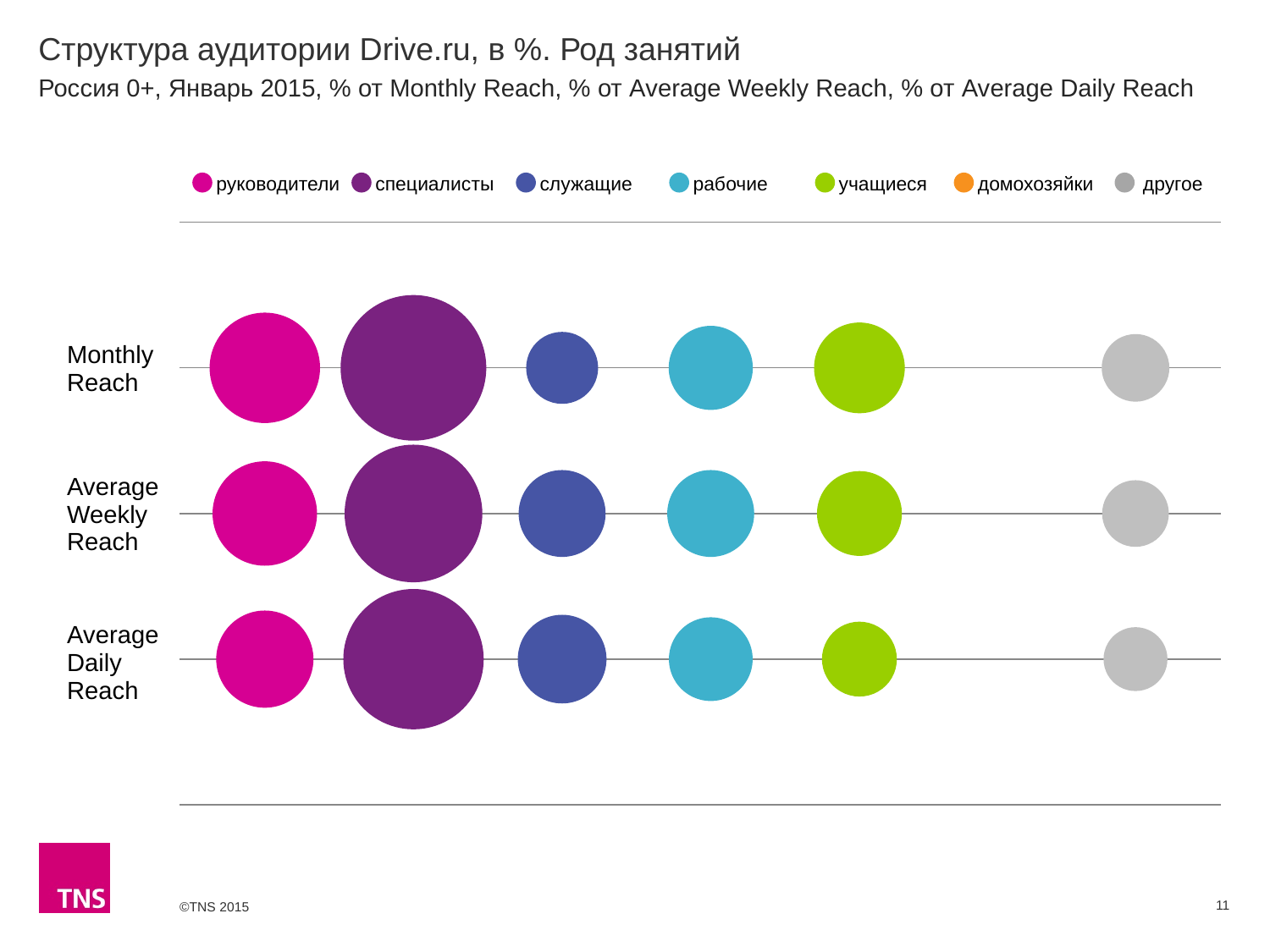
What is the title of the chart on the slide? Структура аудитории Drive.ru, в %. Род занятий How many occupation categories does the legend list? 7 Which row is listed first (at the top) of the chart? Monthly Reach In the Average Weekly Reach row, which bubble is larger: специалисты or рабочие? специалисты Which occupation has the largest bubble in the Monthly Reach row? специалисты In the Monthly Reach row, which bubble is larger: учащиеся or другое? учащиеся How many reach rows (categories) are plotted on the chart? 3 In the Monthly Reach row, which bubble is larger: руководители or служащие? руководители Which legend category has no visible bubble in any row? домохозяйки What kind of chart is shown on the slide? Bubble chart Which occupation has the largest bubble in the Average Daily Reach row? специалисты